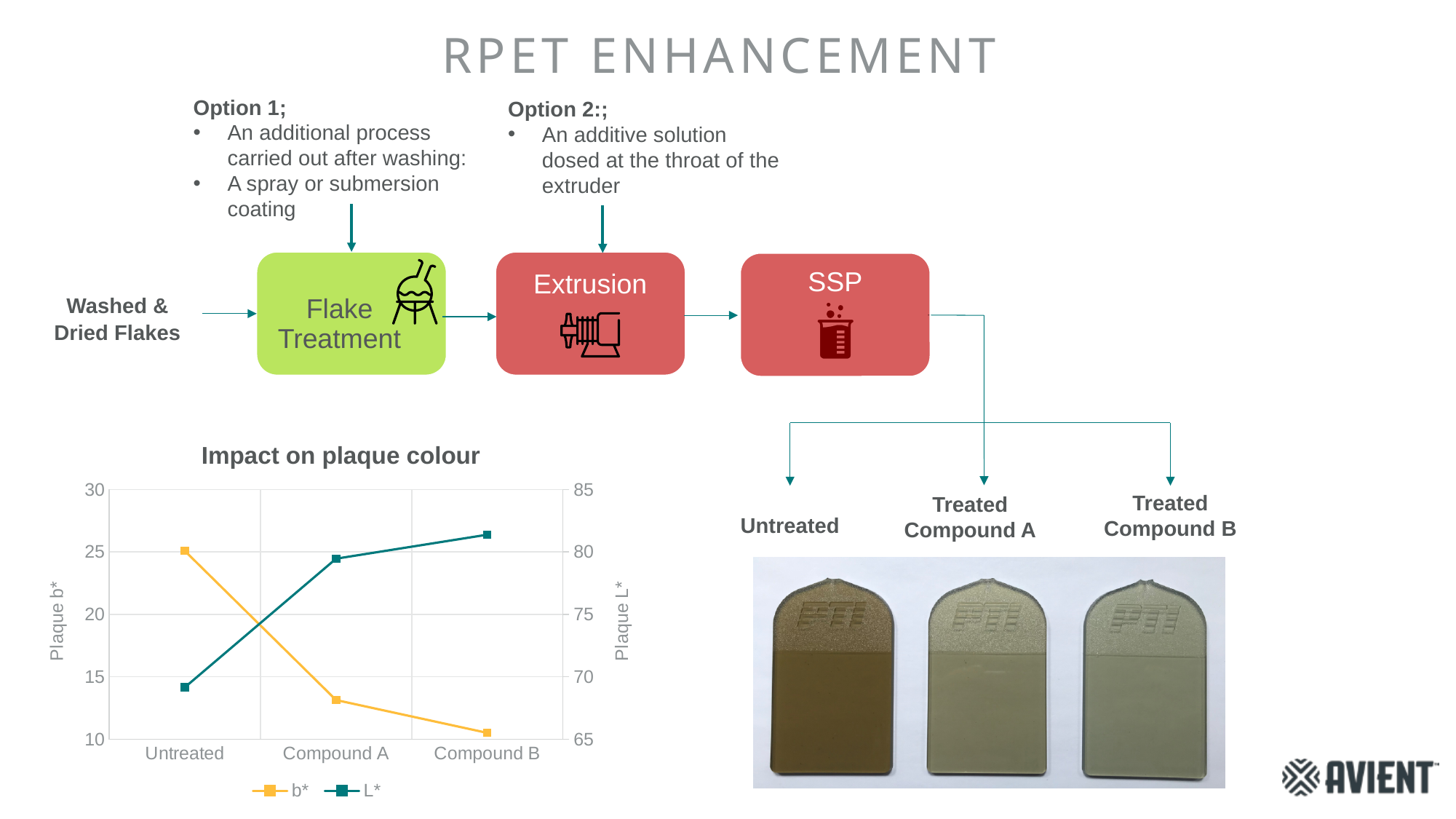
In the "Impact on plaque colour" chart, does the L* series rise or fall from Untreated to Compound B? rise In the "Impact on plaque colour" chart, is the L* value for Untreated greater or less than 75? less Which category has the lowest b* value in the "Impact on plaque colour" chart? Compound B What are the two series named in the legend of the "Impact on plaque colour" chart? b* and L* Which category has the highest L* value in the "Impact on plaque colour" chart? Compound B What kind of chart is "Impact on plaque colour"? line chart How many categories are shown on the x axis of the "Impact on plaque colour" chart? 3 In the "Impact on plaque colour" chart, is the b* value for Compound A greater or less than 15? less In the "Impact on plaque colour" chart, does the b* series rise or fall from Untreated to Compound B? fall Which category has the highest b* value in the "Impact on plaque colour" chart? Untreated How many series does the legend of the "Impact on plaque colour" chart list? 2 Which category has the lowest L* value in the "Impact on plaque colour" chart? Untreated